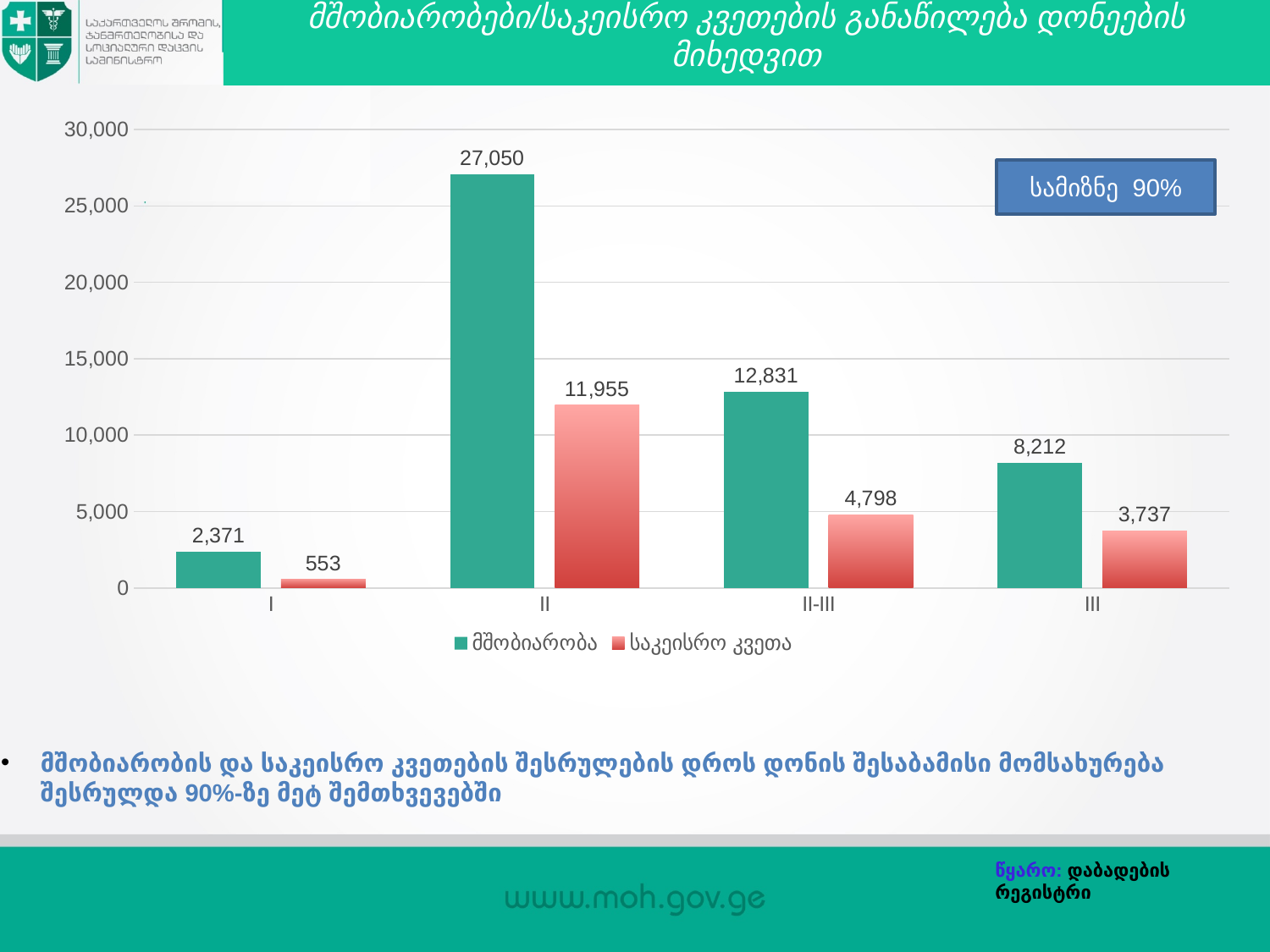
Which category has the lowest value for საკეისრო კვეთა? I How many categories are shown on the x axis? 4 What is the value of მშობიარობა for category II? 27,050 What percentage is shown in the blue box in the upper right of the chart? 90% What is the value of მშობიარობა for category III? 8,212 What is the difference between მშობიარობა and საკეისრო კვეთა for category II? 15,095 How many series does the legend list? 2 Which category has the highest value for მშობიარობა? II Which is larger: მშობიარობა for category II-III or მშობიარობა for category III? მშობიარობა for category II-III What type of chart is shown on the slide? bar chart What is the value of საკეისრო კვეთა for category I? 553 What is the value of საკეისრო კვეთა for category II-III? 4,798